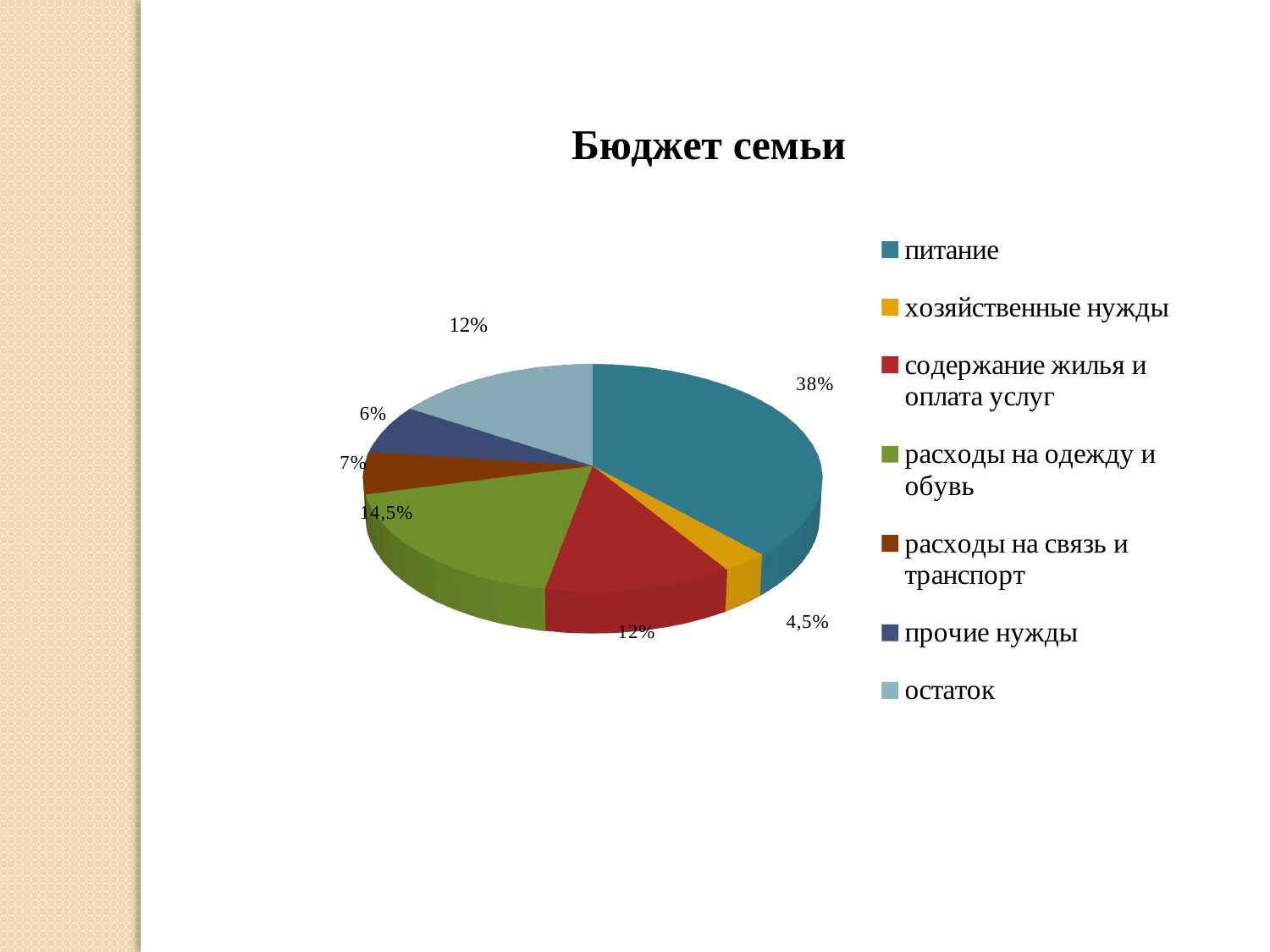
Which category has the smallest share of the budget? хозяйственные нужды What share of the budget goes to расходы на одежду и обувь? 14,5% Which category has the largest share of the budget? питание How many slices does the pie chart have? 7 What share of the budget goes to питание? 38% How many entries does the legend list? 7 Which is larger, the share for прочие нужды or the share for расходы на связь и транспорт? расходы на связь и транспорт What type of chart is shown on the slide? pie chart What share of the budget goes to расходы на связь и транспорт? 7% What is the title of the chart? Бюджет семьи What is the difference between the share for питание and the share for расходы на одежду и обувь? 23,5% What share of the budget goes to хозяйственные нужды? 4,5%